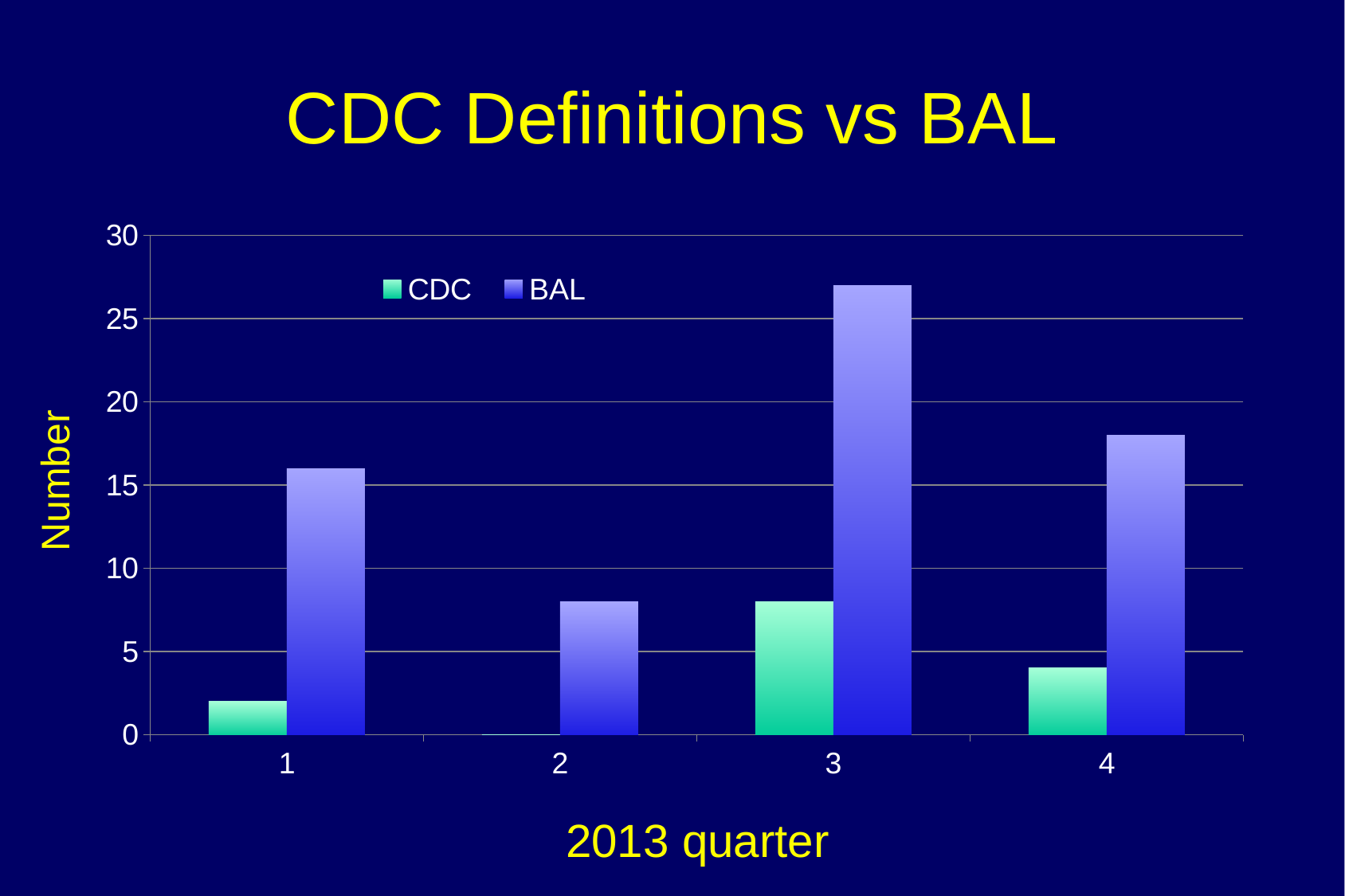
What is the label of the y axis? Number Which is larger in quarter 4, the CDC value or the BAL value? BAL In which quarter is the CDC value highest? 3 In which quarter is the BAL value lowest? 2 Is the CDC value for quarter 4 greater or less than 5? less What is the title of the chart? CDC Definitions vs BAL How many quarters are shown on the x axis? 4 Is the BAL value for quarter 1 greater or less than 15? greater What kind of chart is shown on the slide? bar chart How many series does the legend list? 2 Is the BAL value for quarter 3 greater or less than 25? greater In which quarter is the BAL value highest? 3